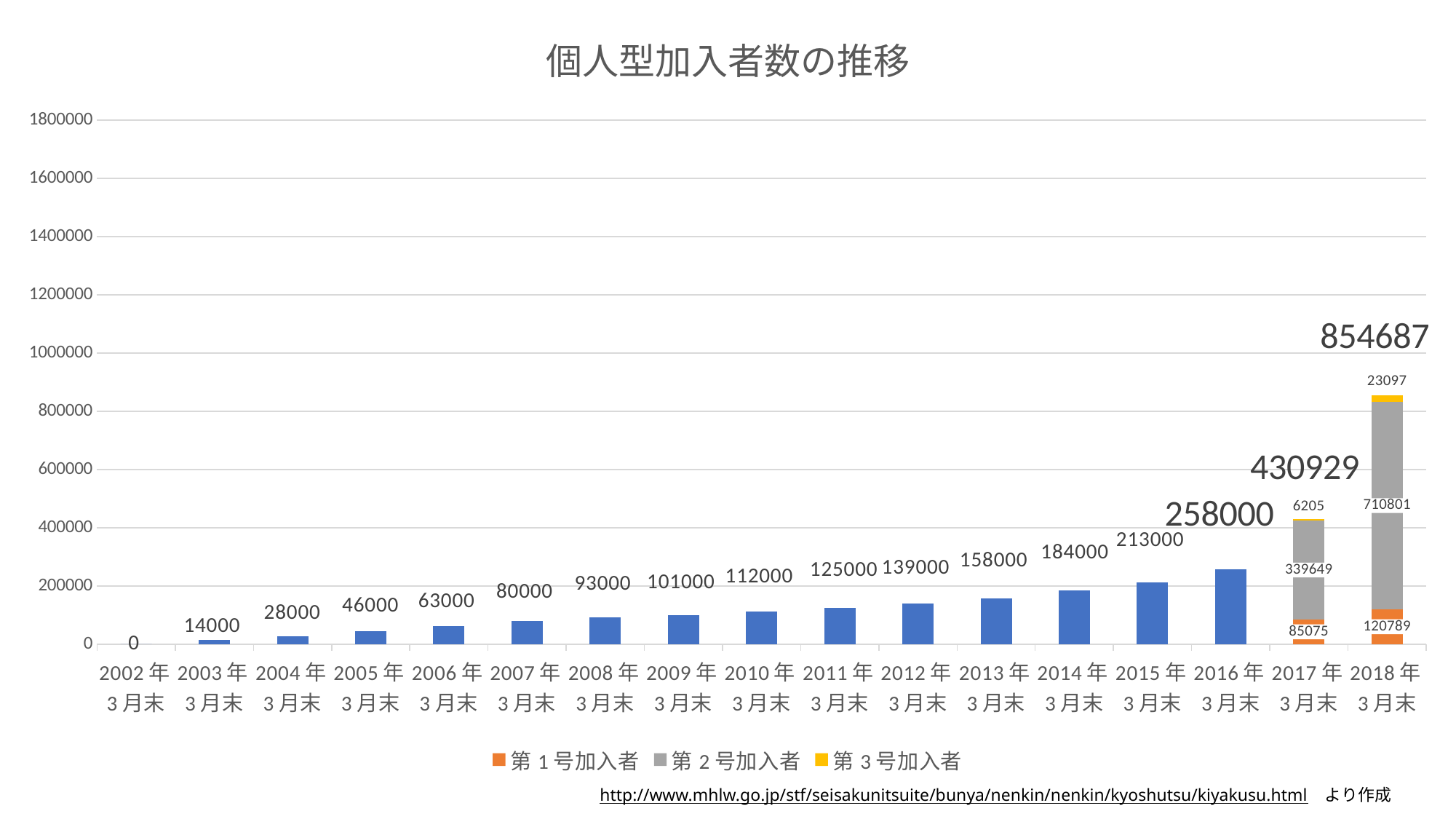
What is the 第2号加入者 value for 2018年3月末? 710801 What type of chart is shown on the slide? bar chart What is the value labelled for 2010年3月末? 112000 What is the title of the chart? 個人型加入者数の推移 How many series does the legend list? 3 Which year has the highest total number of 加入者? 2018年3月末 How many year categories are shown along the x axis? 17 What is the difference between the totals for 2018年3月末 and 2017年3月末? 423758 What is the 第3号加入者 value for 2017年3月末? 6205 Do the values generally rise or fall from 2002年3月末 to 2018年3月末? rise What is the total labelled for the stacked bar at 2018年3月末? 854687 Which is larger, the 第1号加入者 value for 2018年3月末 or the 第1号加入者 value for 2017年3月末? 2018年3月末